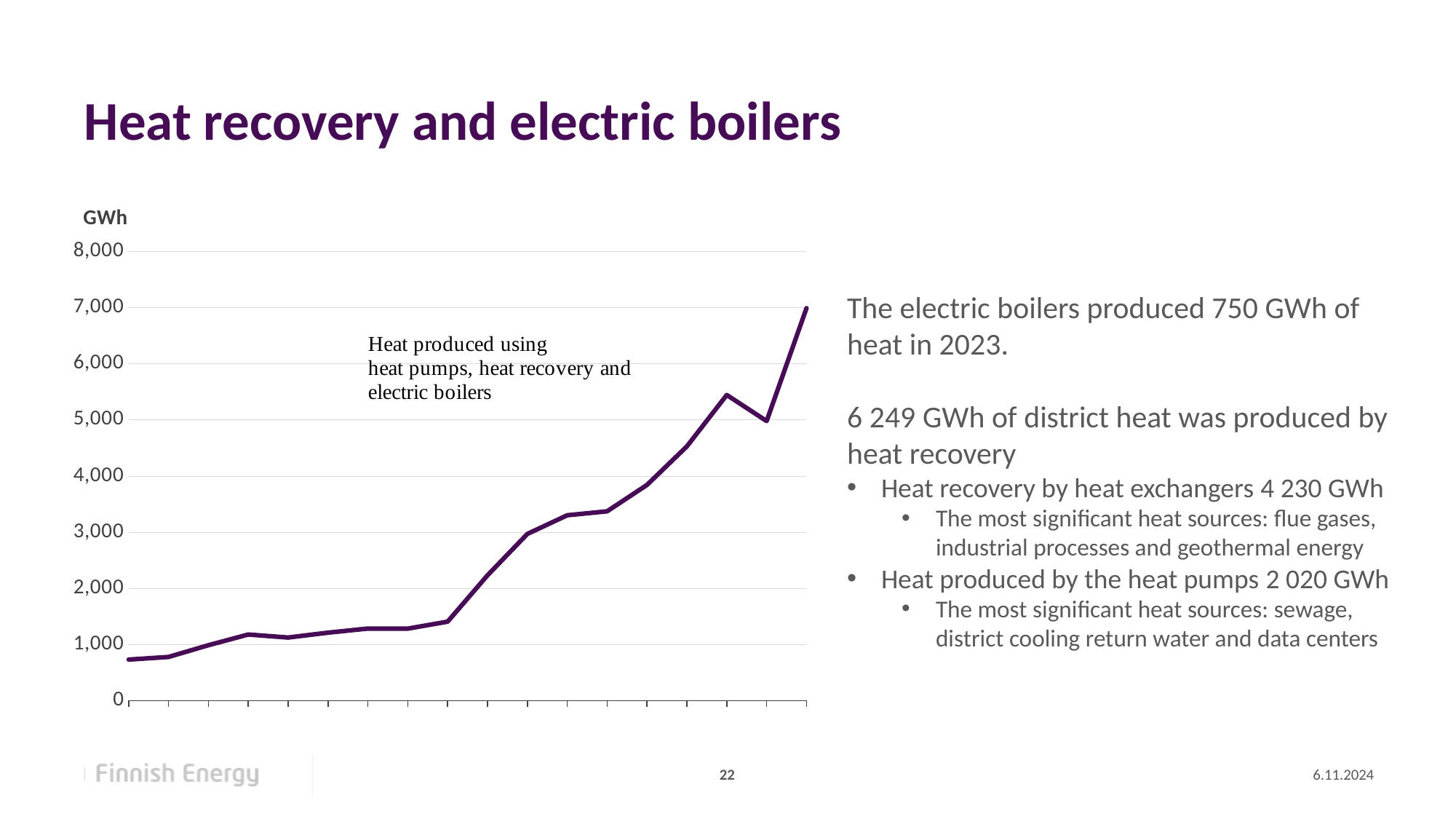
Is the value at the final point of the line greater or less than 8,000? less Which point on the line has the highest value, the first or the last? the last What kind of chart is shown on the slide? line chart What unit is shown on the y axis of the chart? GWh Overall, does the line rise or fall from left to right? rise Is the value at the first (leftmost) point of the line greater or less than 1,000? less What is the highest value labelled on the y axis? 8,000 Is the value at the final (rightmost) point of the line greater or less than 6,000? greater How many lines are plotted on the chart? 1 What does the text annotation inside the chart say the line represents? Heat produced using heat pumps, heat recovery and electric boilers